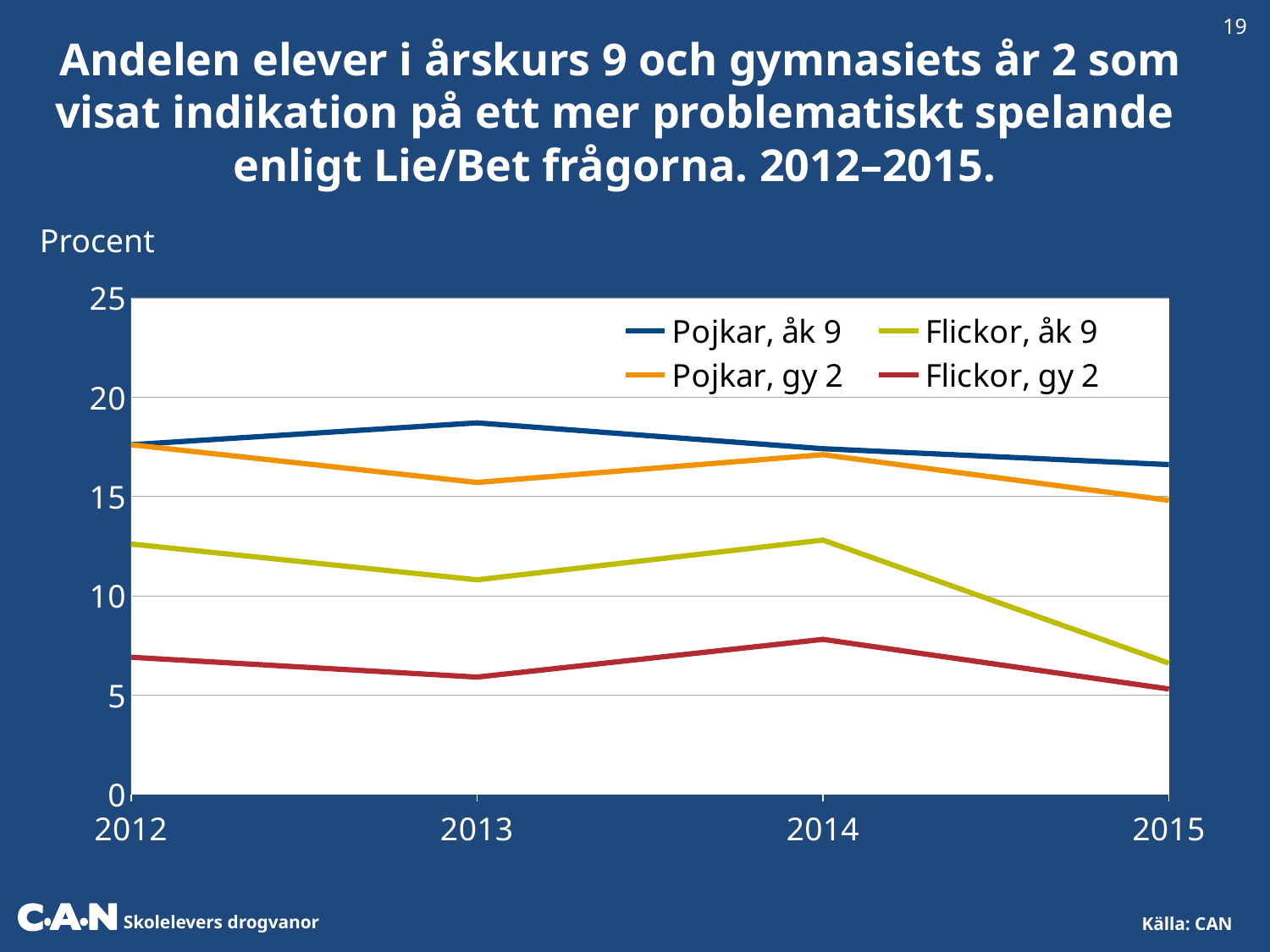
What unit is shown on the y axis label? Procent Is the value for Flickor, gy 2 in 2014 greater or less than 10? less How many series does the legend list? 4 Which is larger in 2015: Flickor, åk 9 or Pojkar, gy 2? Pojkar, gy 2 Is the value for Pojkar, gy 2 in 2015 greater or less than 10? greater Is the value for Flickor, åk 9 in 2015 greater or less than 10? less Which series has the lowest values across all years? Flickor, gy 2 Which series has the highest value in 2013? Pojkar, åk 9 How many years are shown along the x axis? 4 What kind of chart is shown on the slide? line chart Does the value for Flickor, åk 9 rise or fall from 2014 to 2015? fall